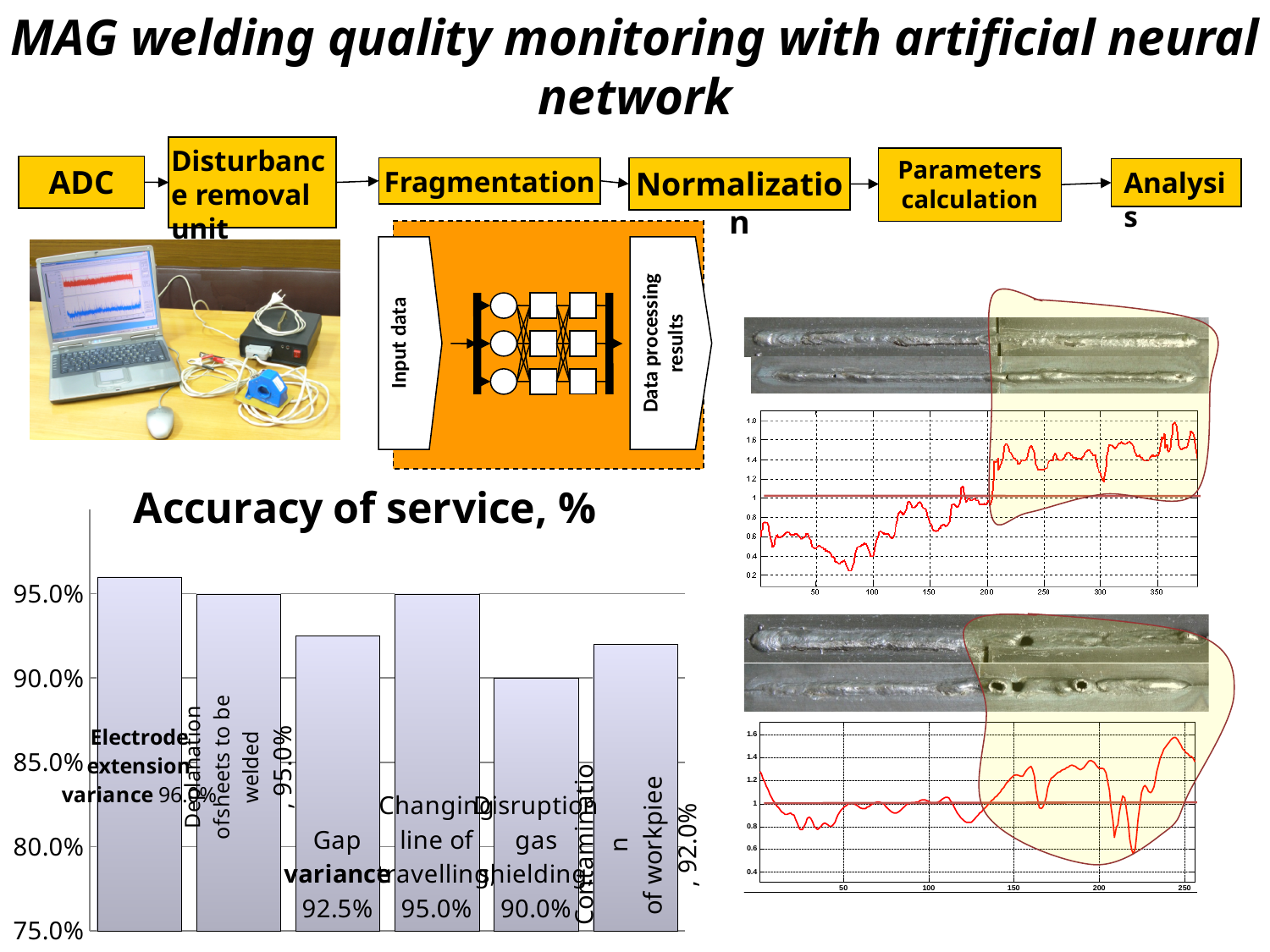
In the 'Accuracy of service, %' chart, which category has the highest accuracy? Electrode extension variance In the 'Accuracy of service, %' chart, which is larger: the value for Gap variance or the value for Contamination of workpiece? Gap variance How many bars are shown in the 'Accuracy of service, %' chart? 6 In the 'Accuracy of service, %' chart, what is the value for Gap variance? 92.5% What is the title of the bar chart on the lower left of the slide? Accuracy of service, % In the 'Accuracy of service, %' chart, is the value for Changing line of travelling greater or less than 90.0%? greater In the 'Accuracy of service, %' chart, what is the value for Disruption gas shielding? 90.0% What kind of chart is the 'Accuracy of service, %' chart? bar chart In the 'Accuracy of service, %' chart, what is the difference between the values for Electrode extension variance and Disruption gas shielding? 6.0% In the 'Accuracy of service, %' chart, what is the value for Electrode extension variance? 96.0% In the 'Accuracy of service, %' chart, which category has the lowest accuracy? Disruption gas shielding In the 'Accuracy of service, %' chart, what is the value for Contamination of workpiece? 92.0%